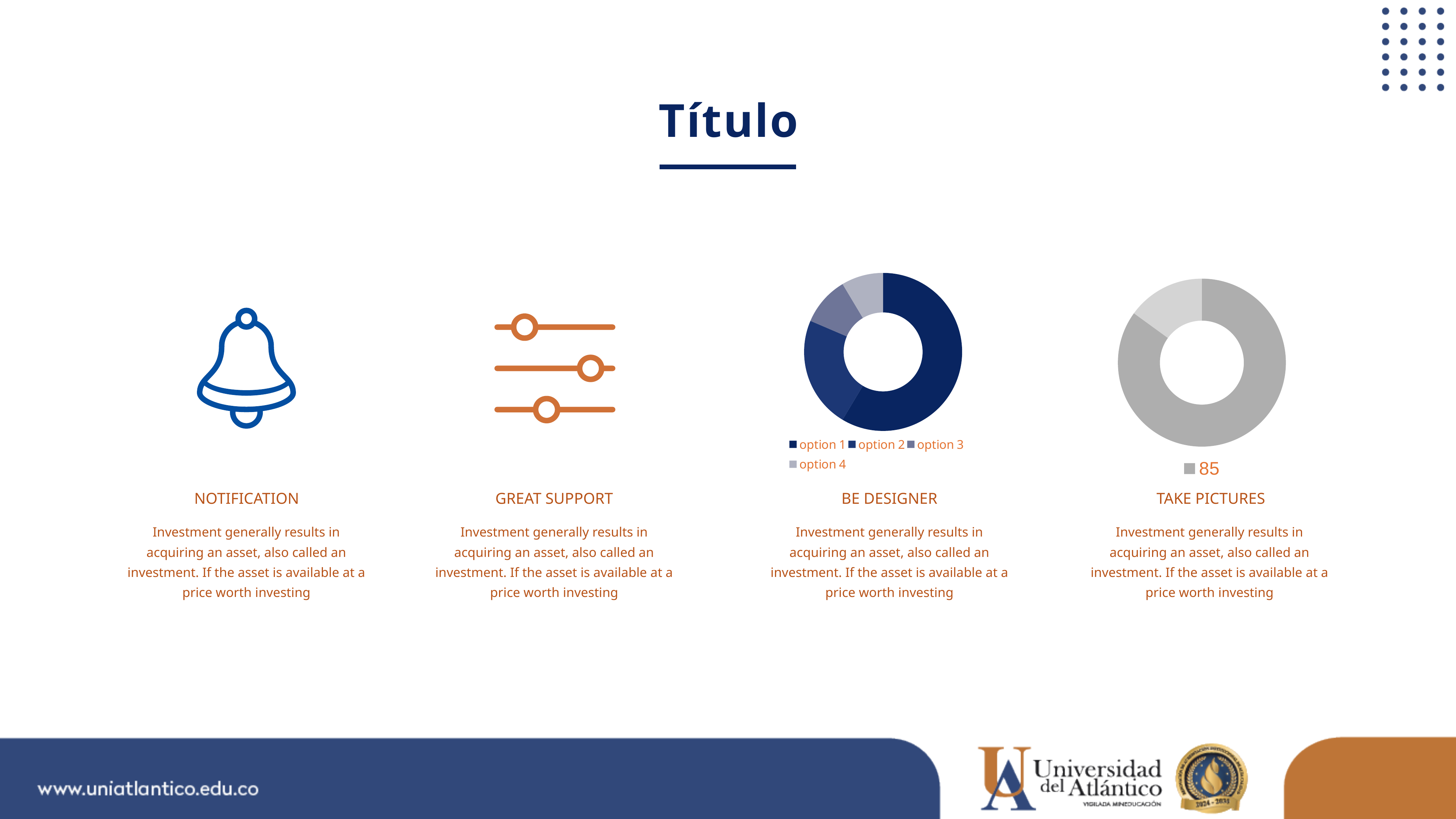
How many charts are on the slide? 2 What kind of chart is shown under the heading BE DESIGNER? Doughnut chart What kind of chart is shown under the heading TAKE PICTURES? Doughnut chart In the chart under BE DESIGNER, which slice is larger, option 1 or option 2? option 1 In the chart under TAKE PICTURES, how many entries does the legend list? 1 In the chart under BE DESIGNER, what are the legend entries? option 1, option 2, option 3, option 4 In the chart under BE DESIGNER, which slice is larger, option 2 or option 4? option 2 In the chart under BE DESIGNER, which category has the largest slice? option 1 In the chart under TAKE PICTURES, what is the legend entry shown? 85 In the chart under BE DESIGNER, how many entries does the legend list? 4